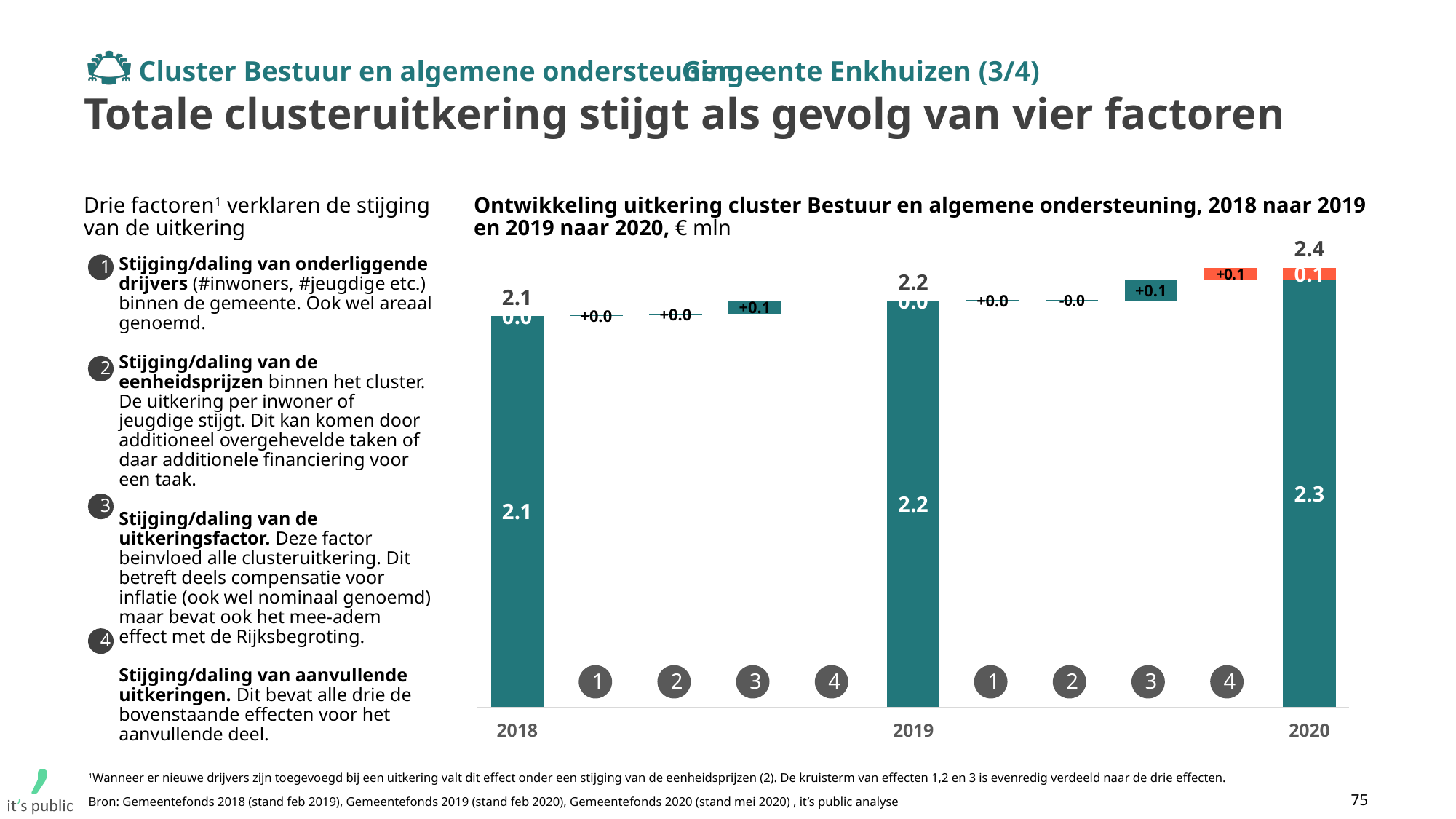
What is the value of factor 4 in the step from 2019 to 2020? +0.1 Do the yearly totals rise or fall from 2018 to 2020? rise What is the total value shown above the 2019 bar? 2.2 What is the value of factor 3 in the step from 2018 to 2019? +0.1 What is the difference between the 2020 total and the 2018 total? 0.3 Which year has the highest total uitkering? 2020 What is the value of factor 3 in the step from 2019 to 2020? +0.1 What is the total value shown above the 2018 bar? 2.1 What kind of chart is shown on the slide? bar chart (waterfall) What is the value of the orange (top) segment of the 2020 bar? 0.1 Which year has the lowest total uitkering? 2018 What is the total value shown above the 2020 bar? 2.4